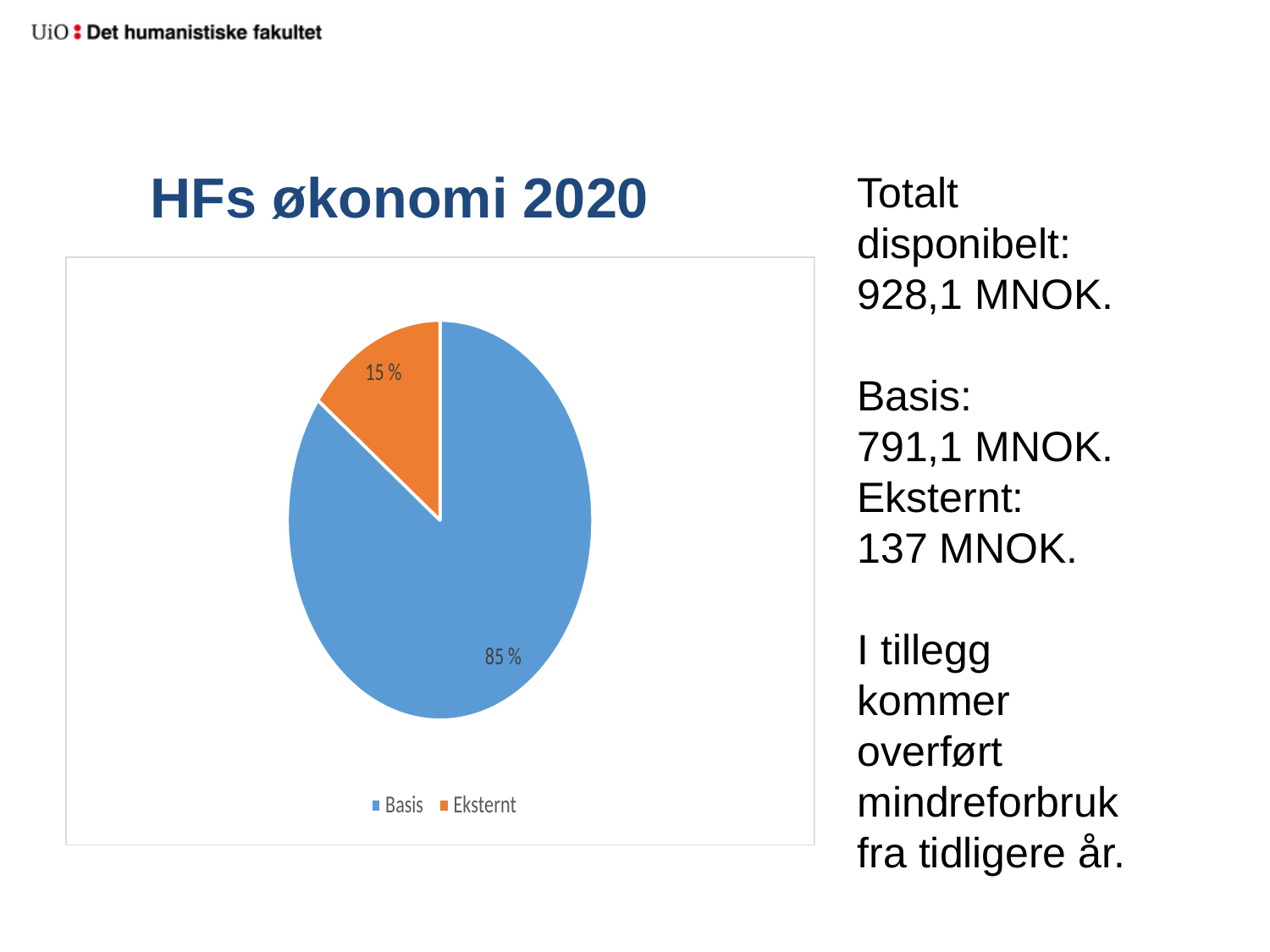
What kind of chart is shown on the slide? pie chart What is the difference in percentage points between the Basis and Eksternt slices? 70 percentage points Which slice of the pie is the largest? Basis What share of the pie does Eksternt represent? 15 % How many entries does the legend list? 2 What share of the pie does Basis represent? 85 % What colour is the Eksternt slice? orange Which slice of the pie is the smallest? Eksternt How many slices does the pie chart have? 2 Which is larger, the Basis slice or the Eksternt slice? Basis What colour is the Basis slice? blue